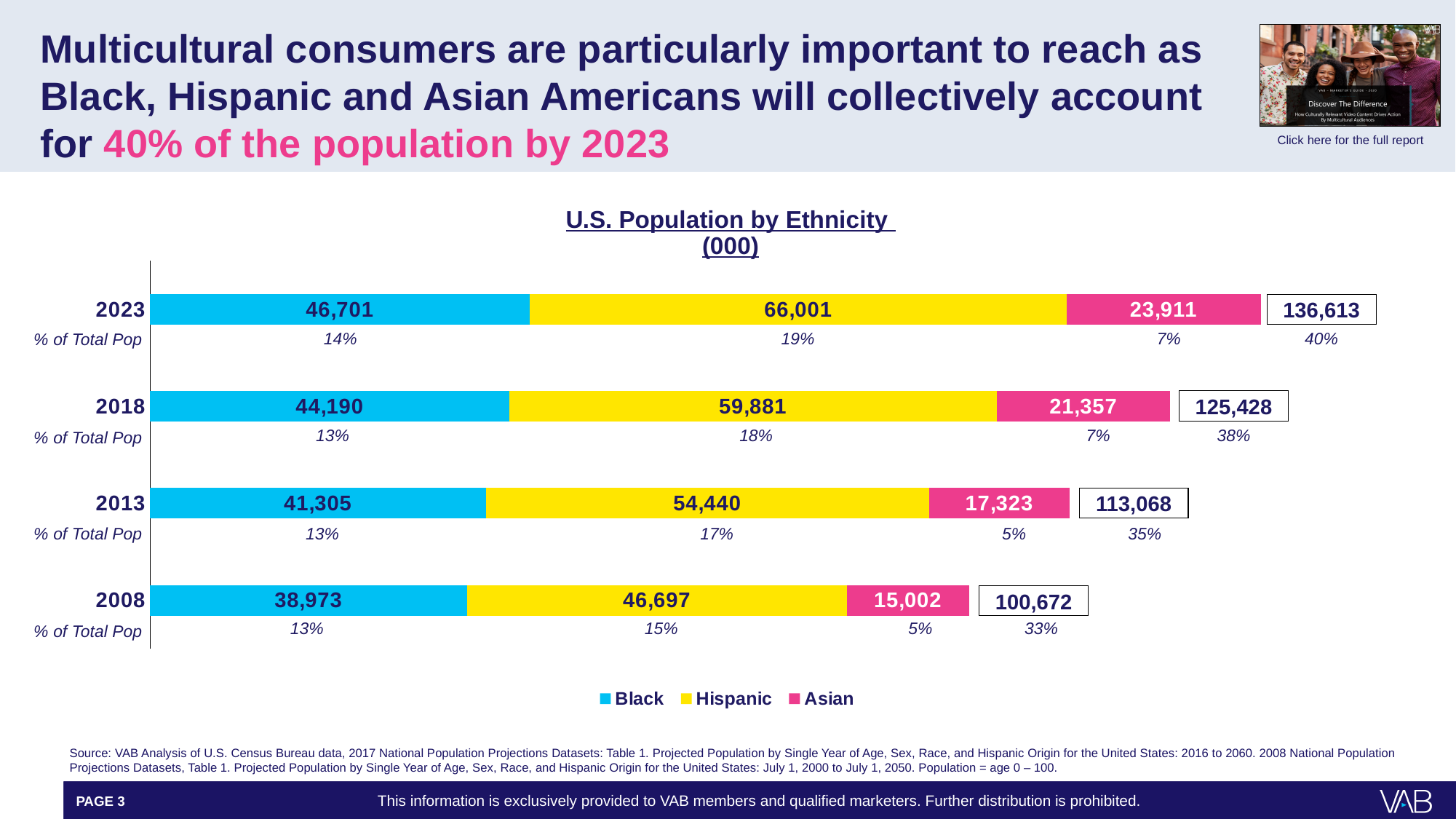
What is the total of the stacked bar for 2013? 113,068 What is the value for Asian in 2018? 21,357 How many years are shown in the chart? 4 How many series does the legend list? 3 What is the total of the stacked bar for 2023? 136,613 What is the value for Black in 2008? 38,973 What is the value for Hispanic in 2023? 66,001 Which is larger: the Hispanic value in 2013 or the Black value in 2023? Hispanic value in 2013 What is the difference between the Black value in 2023 and the Black value in 2018? 2,511 What kind of chart is shown on the slide? Stacked bar chart Which year has the lowest total population across the three groups? 2008 Which year has the highest total population across the three groups? 2023